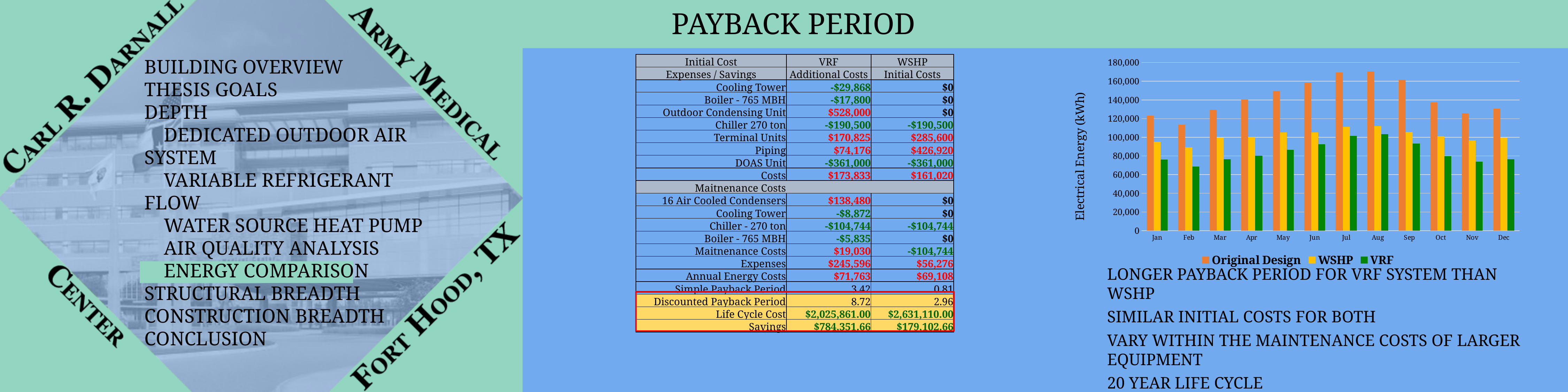
What is the title of the chart's vertical axis? Electrical Energy (kWh) Do the Original Design values rise or fall from Aug to Nov? fall Is the VRF value for Feb greater or less than 80,000? less Is the Original Design value for Jul greater or less than 160,000? greater In which month is the VRF value lowest? Feb How many series does the chart's legend list? 3 Is the Original Design value for Feb greater or less than 120,000? less How many months are plotted along the x axis of the chart? 12 In Jan, which is larger: the WSHP value or the VRF value? WSHP In which month is the Original Design value lowest? Feb What kind of chart is shown on the slide? bar chart Which series in the chart is shown in green? VRF